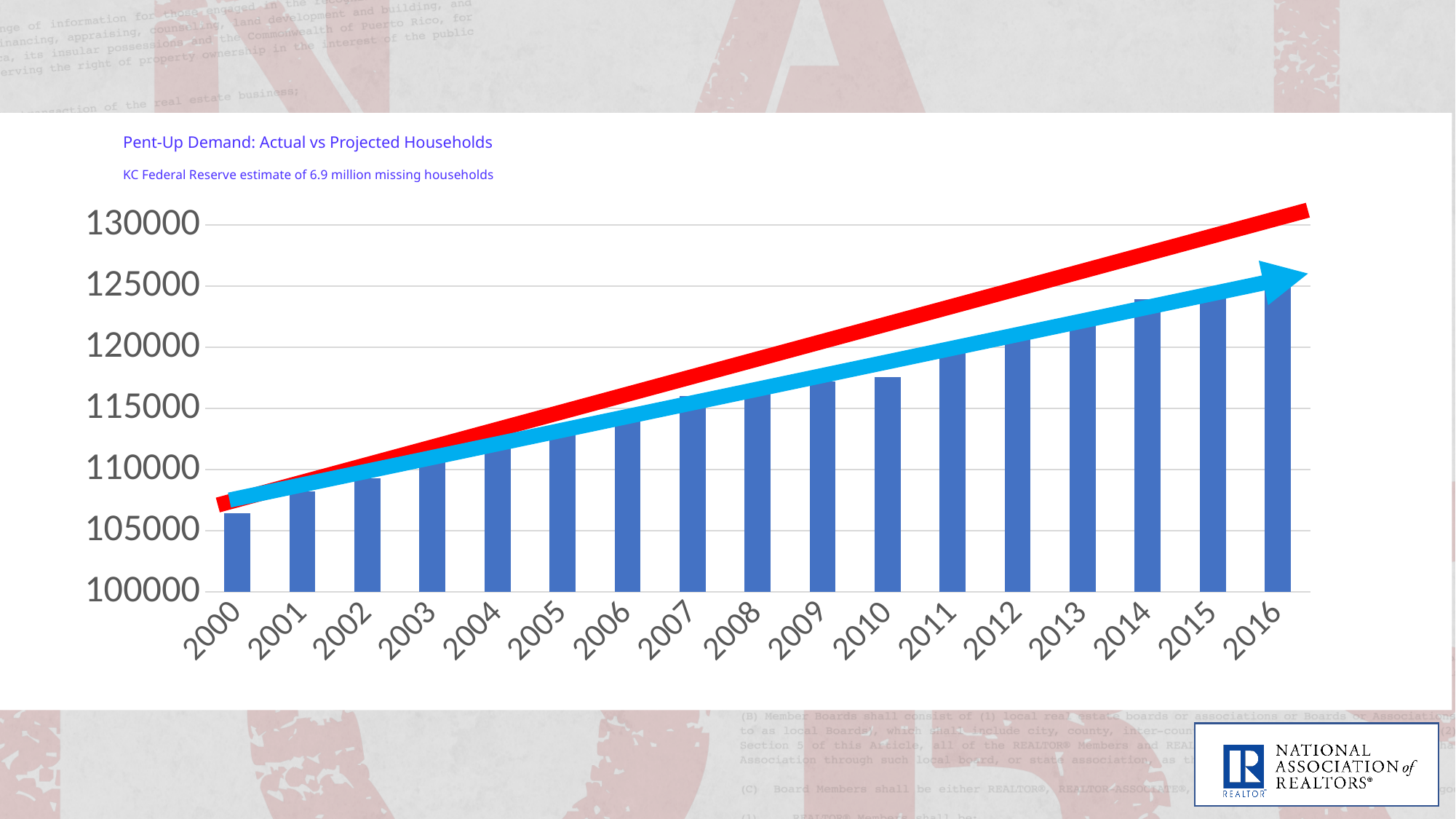
How many years are shown on the x axis of the chart? 17 Which year has the larger value, 2005 or 2010? 2010 Which year has the shortest bar? 2000 Is the value for 2010 greater or less than 115000? greater Which year has the tallest bar? 2016 Is the value for 2000 greater or less than 105000? greater Is the value for 2010 greater or less than 120000? less Do the bar values rise or fall from 2000 to 2016? rise What kind of chart is shown on the slide? bar chart What is the title of the chart? Pent-Up Demand: Actual vs Projected Households